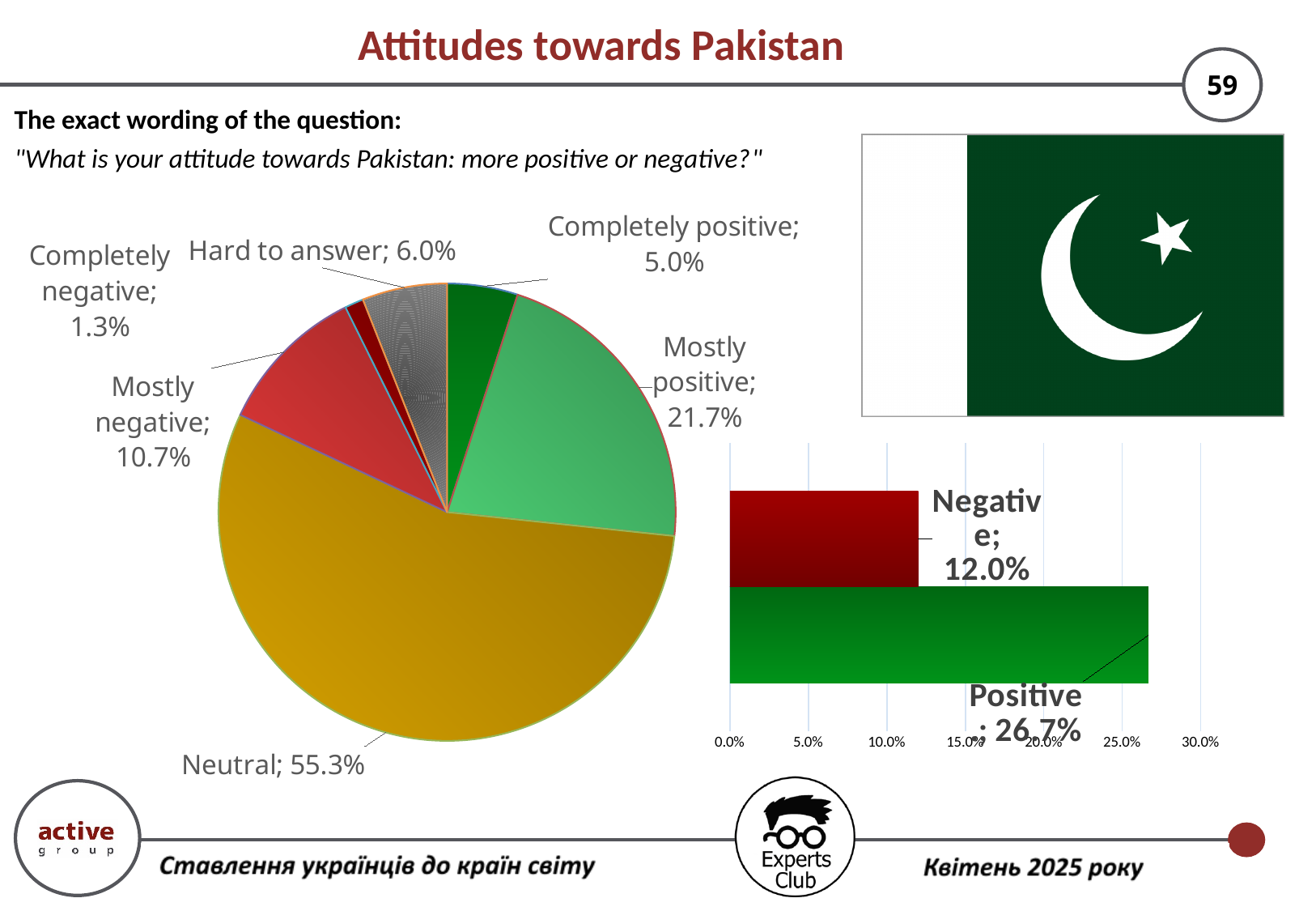
In the bar chart on the right, what is the difference between Positive and Negative? 14.7% In the pie chart, what is the value for Mostly positive? 21.7% In the bar chart on the right, what is the value for Positive? 26.7% In the pie chart, which category has the largest slice? Neutral In the bar chart on the right, what is the value for Negative? 12.0% In the pie chart, what is the value for Completely negative? 1.3% In the pie chart, what is the difference between Mostly negative and Hard to answer? 4.7% In the pie chart, which is larger: Mostly positive or Mostly negative? Mostly positive What type of chart is shown on the right side of the slide? Bar chart In the pie chart, what share of respondents answered Neutral? 55.3% In the pie chart, which category has the smallest slice? Completely negative In the pie chart, how many categories are shown? 6